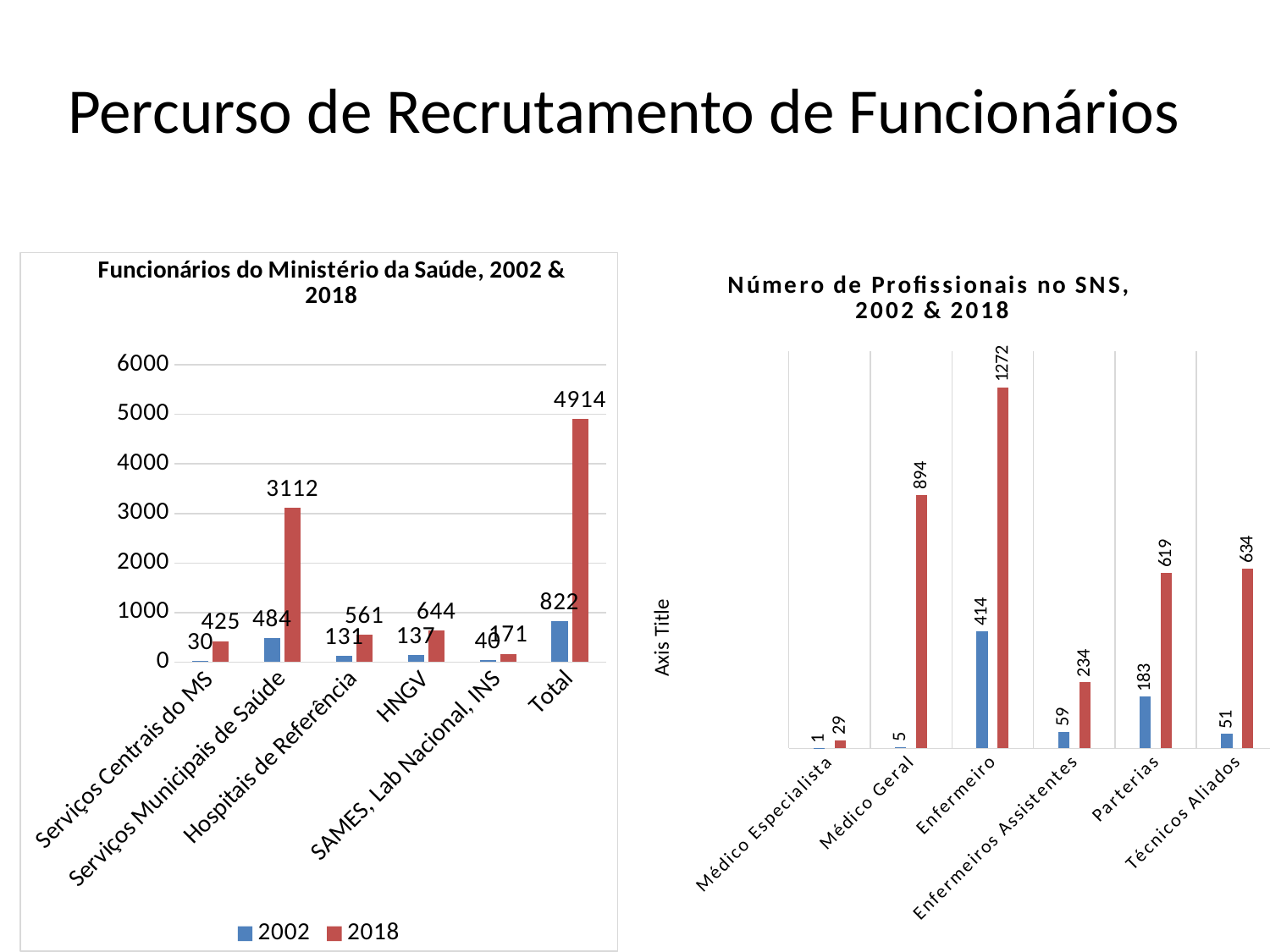
What type of chart is 'Funcionários do Ministério da Saúde, 2002 & 2018'? Bar chart In the chart 'Funcionários do Ministério da Saúde, 2002 & 2018', what is the 2002 value for HNGV? 137 In the chart 'Número de Profissionais no SNS, 2002 & 2018', what is the value of the red bar for Enfermeiro? 1272 In the chart 'Funcionários do Ministério da Saúde, 2002 & 2018', excluding Total, which category has the highest 2018 value? Serviços Municipais de Saúde In the chart 'Funcionários do Ministério da Saúde, 2002 & 2018', what is the difference between the 2018 and 2002 values for Total? 4092 In the chart 'Número de Profissionais no SNS, 2002 & 2018', which category has the highest red bar? Enfermeiro In the chart 'Funcionários do Ministério da Saúde, 2002 & 2018', which category has the lowest 2002 value? Serviços Centrais do MS In the chart 'Funcionários do Ministério da Saúde, 2002 & 2018', what is the 2018 value for Serviços Municipais de Saúde? 3112 How many series does the legend of the chart 'Funcionários do Ministério da Saúde, 2002 & 2018' list? 2 In the chart 'Número de Profissionais no SNS, 2002 & 2018', what is the value of the blue bar for Parterias? 183 How many categories are shown on the x axis of the chart 'Número de Profissionais no SNS, 2002 & 2018'? 6 In the chart 'Número de Profissionais no SNS, 2002 & 2018', is the red bar for Técnicos Aliados larger than the red bar for Parterias? Yes